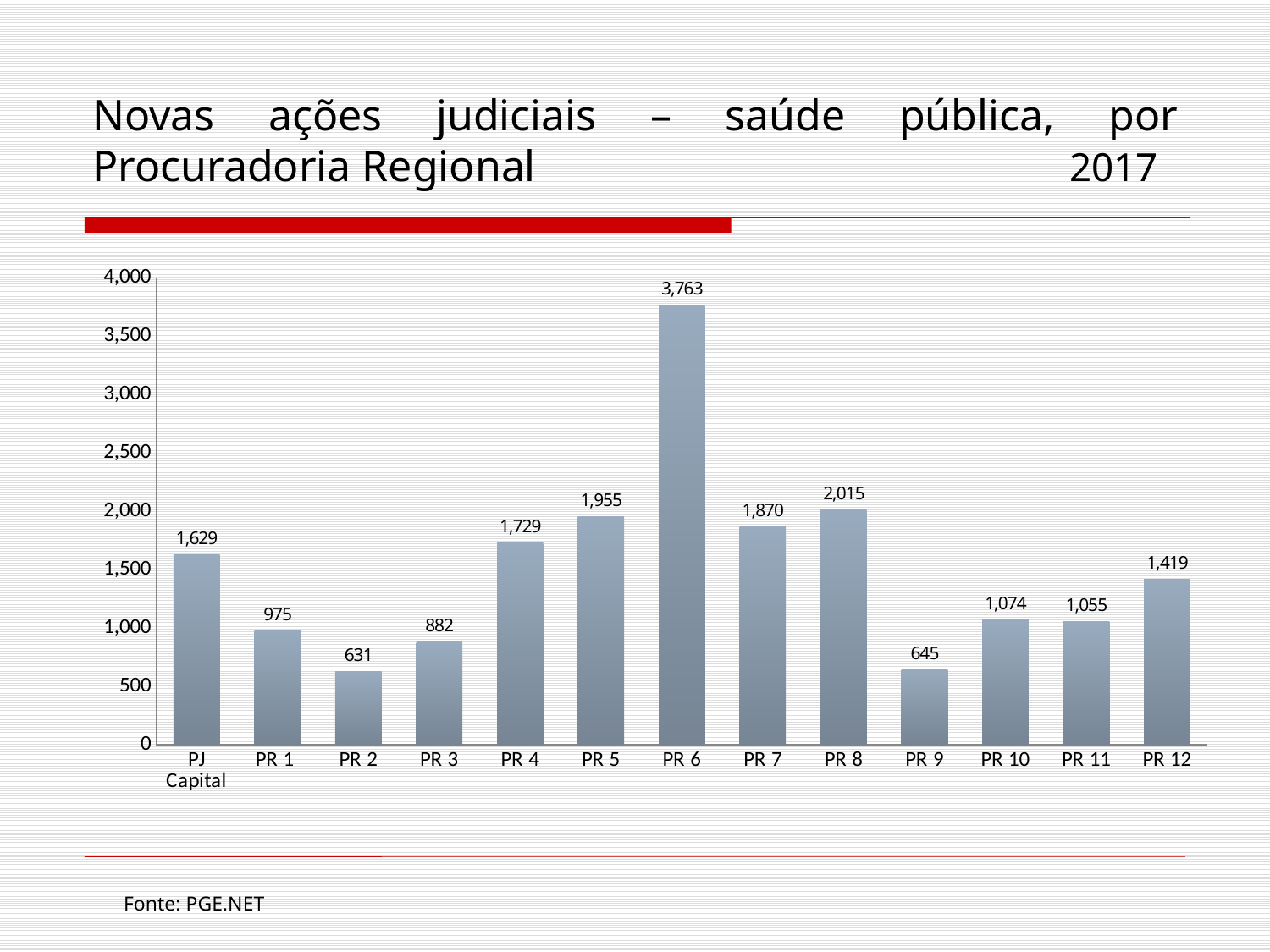
What is the value for PR 6? 3,763 Which category has the highest value? PR 6 What kind of chart is shown on the slide? bar chart Is the value for PR 9 greater or less than 1,000? less Which is larger, the value for PR 12 or the value for PR 3? PR 12 Which category has the lowest value? PR 2 What is the difference between the values for PR 8 and PR 7? 145 What is the value for PJ Capital? 1,629 What is the difference between the values for PR 6 and PR 5? 1,808 How many categories are shown on the x axis? 13 What source is cited below the chart? PGE.NET What is the value for PR 10? 1,074